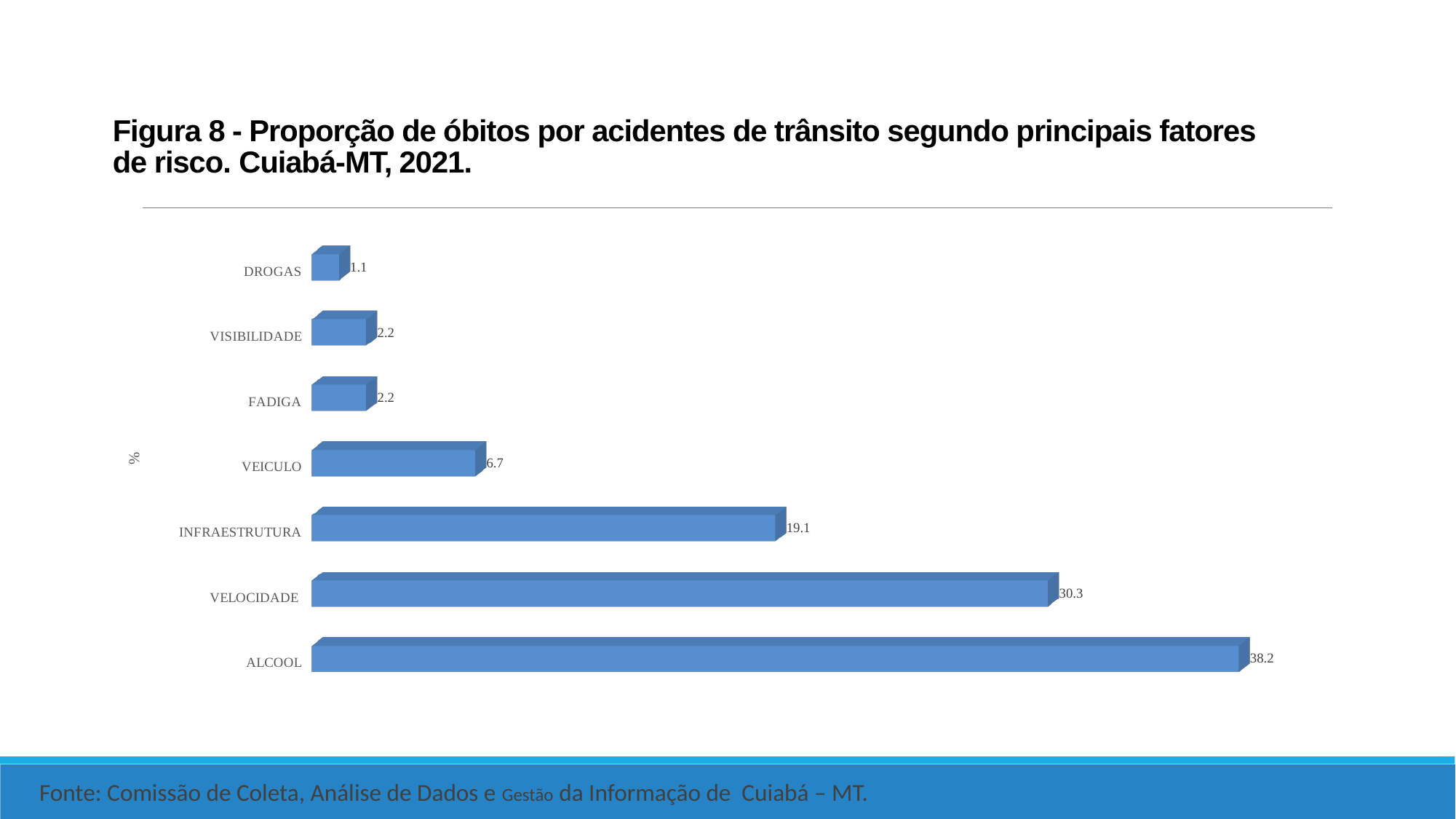
What is the value for ALCOOL? 38.2 Which category has the highest value? ALCOOL What is the difference between the values for ALCOOL and VELOCIDADE? 7.9 What is the value for DROGAS? 1.1 What is the label on the vertical axis of the chart? % Which category has the lowest value? DROGAS What is the value for INFRAESTRUTURA? 19.1 What is the value for VEICULO? 6.7 Which is larger, the value for INFRAESTRUTURA or the value for VEICULO? INFRAESTRUTURA How many categories are shown in the chart? 7 What kind of chart is shown on the slide? Bar chart What is the value for VELOCIDADE? 30.3